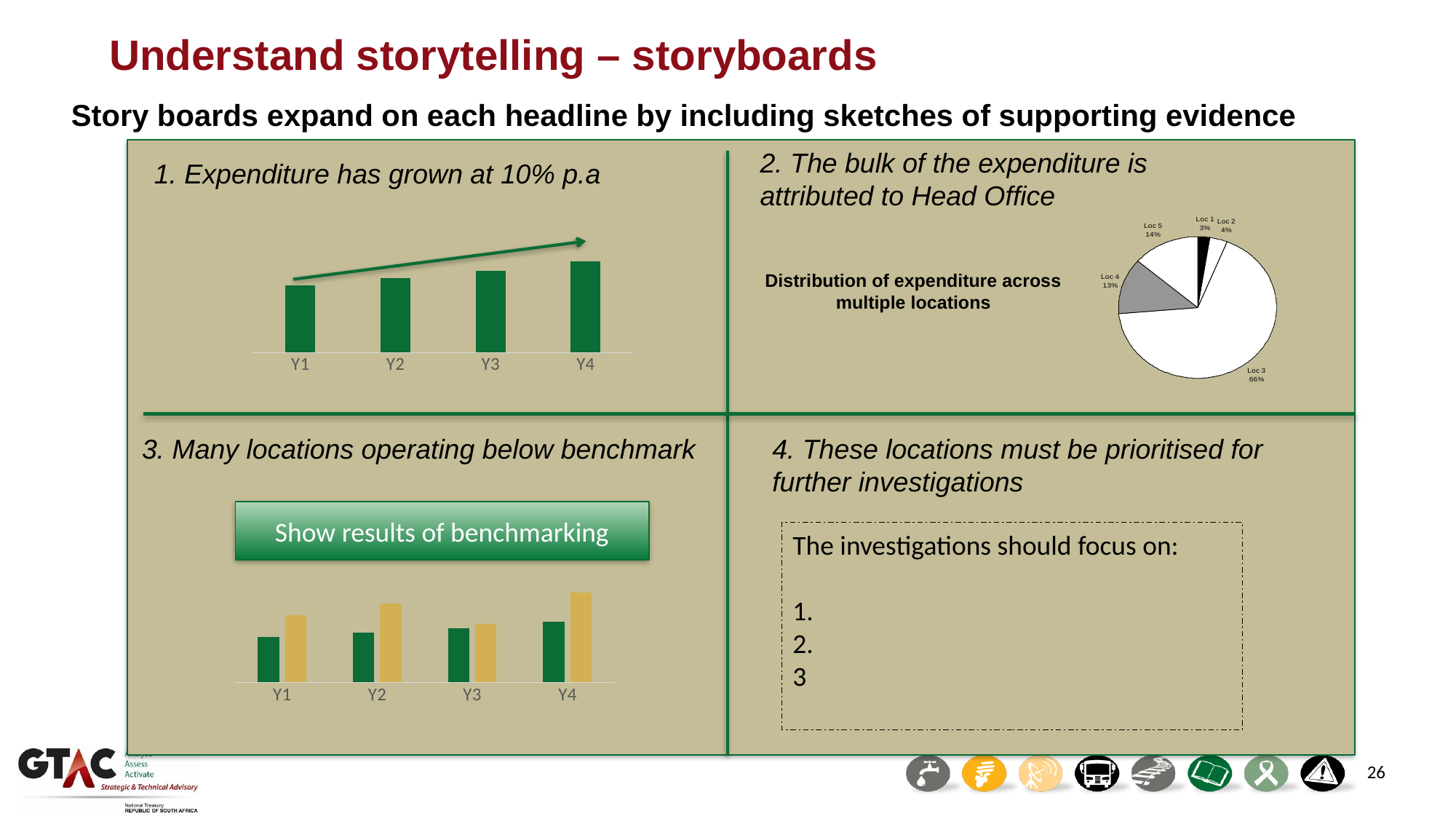
In the pie chart titled 'Distribution of expenditure across multiple locations', how many locations are shown? 5 In the bar chart in the top-left panel under 'Expenditure has grown at 10% p.a', do the bars rise or fall from Y1 to Y4? Rise In the pie chart titled 'Distribution of expenditure across multiple locations', what is the difference between the shares of Loc 5 and Loc 4? 1% In the pie chart titled 'Distribution of expenditure across multiple locations', which location has the smallest share? Loc 1 In the pie chart titled 'Distribution of expenditure across multiple locations', which location has the largest share? Loc 3 In the bar chart in the bottom-left panel under 'Many locations operating below benchmark', how many categories are shown on the x axis? 4 In the pie chart titled 'Distribution of expenditure across multiple locations', which has the larger share, Loc 2 or Loc 4? Loc 4 In the pie chart titled 'Distribution of expenditure across multiple locations', what share does Loc 5 have? 14% What type of chart is shown in the top-left panel under 'Expenditure has grown at 10% p.a'? Bar chart In the pie chart titled 'Distribution of expenditure across multiple locations', what share does Loc 1 have? 3% In the pie chart titled 'Distribution of expenditure across multiple locations', what share does Loc 3 have? 66% How many categories are shown on the x axis of the bar chart in the top-left panel under 'Expenditure has grown at 10% p.a'? 4